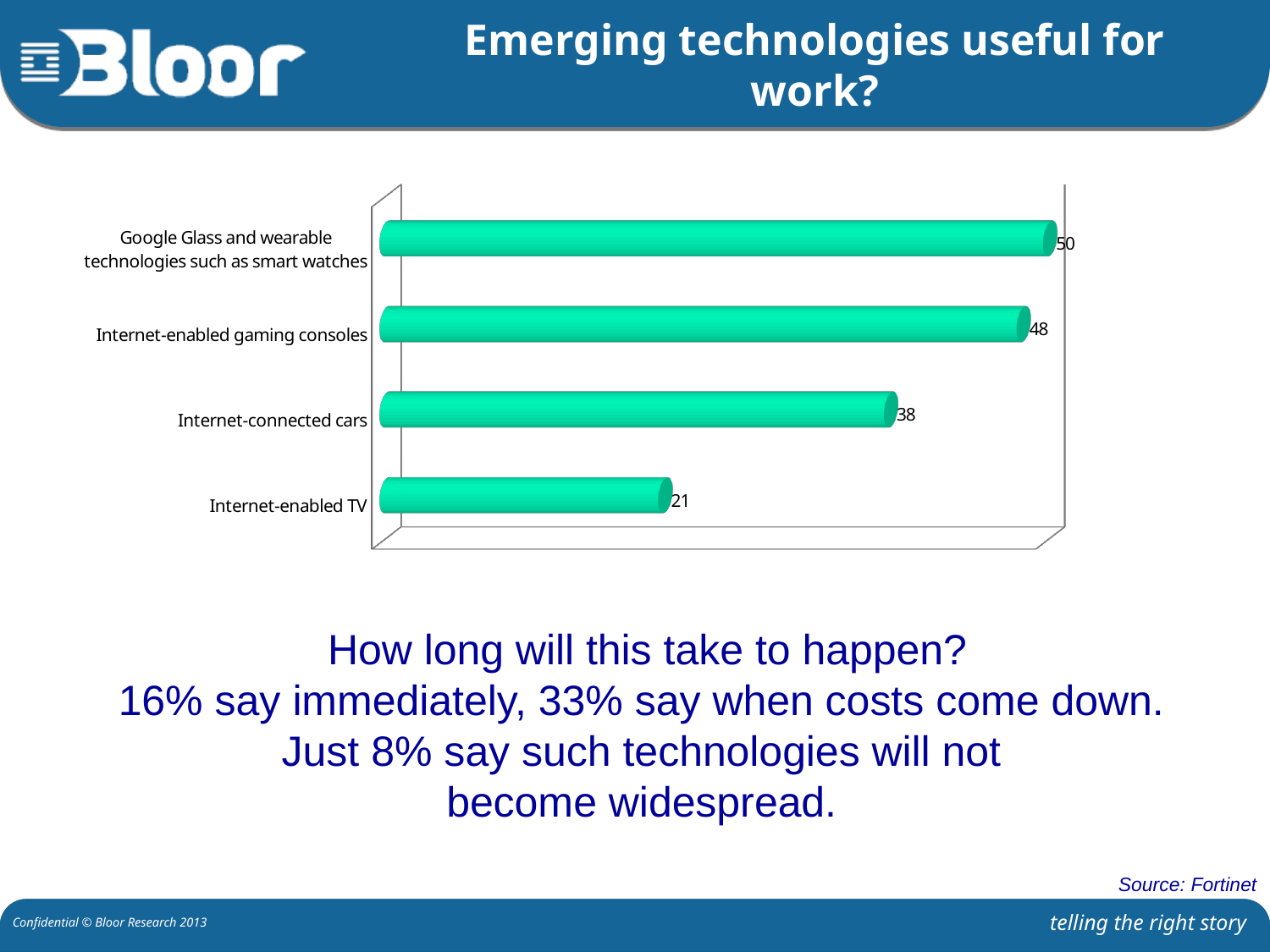
How many categories are shown in the chart? 4 What is the difference between the values for Google Glass and wearable technologies and Internet-connected cars? 12 What is the title of the slide containing the chart? Emerging technologies useful for work? What kind of chart is shown on the slide? Bar chart What is the value for Google Glass and wearable technologies such as smart watches? 50 What is the value for Internet-enabled gaming consoles? 48 What is the value for Internet-enabled TV? 21 Which category has the lowest value? Internet-enabled TV What is the value for Internet-connected cars? 38 Which is larger, the value for Internet-connected cars or the value for Internet-enabled TV? Internet-connected cars Which category has the highest value? Google Glass and wearable technologies such as smart watches What is the difference between the values for Internet-enabled gaming consoles and Internet-enabled TV? 27